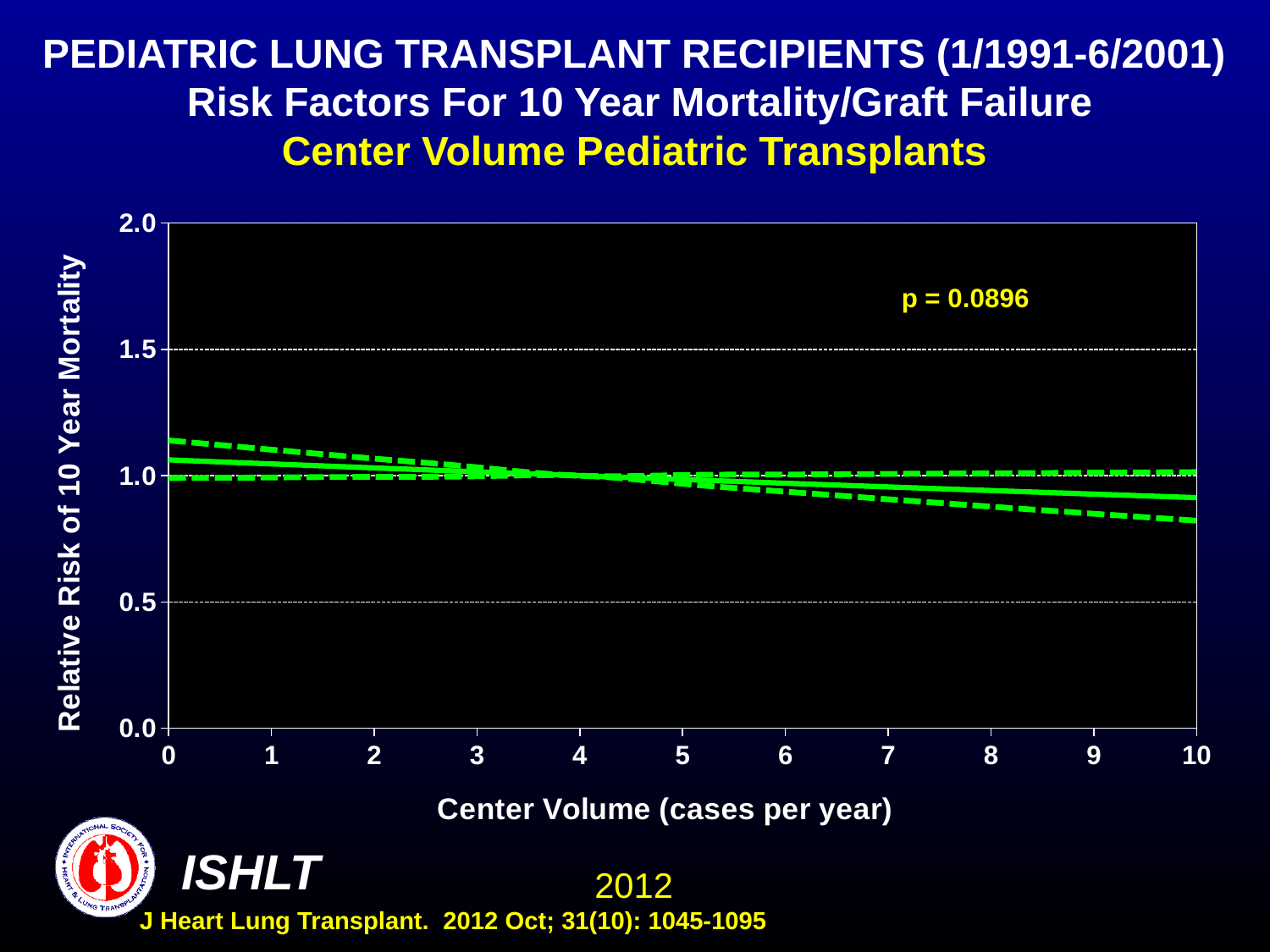
How many tick labels are shown on the x axis? 11 How many lines are plotted on the chart? 3 Is the value of the solid line at a center volume of 5 cases per year greater or less than 1.5? less Is the value of the lower dashed line at a center volume of 10 cases per year greater or less than 1.0? less Does the solid line for relative risk rise or fall as center volume increases from 0 to 10 cases per year? fall Is the value of the upper dashed line at a center volume of 0 greater or less than 1.0? greater What p-value is printed on the chart? p = 0.0896 What is the label of the x axis? Center Volume (cases per year) What kind of chart is shown on the slide? line chart